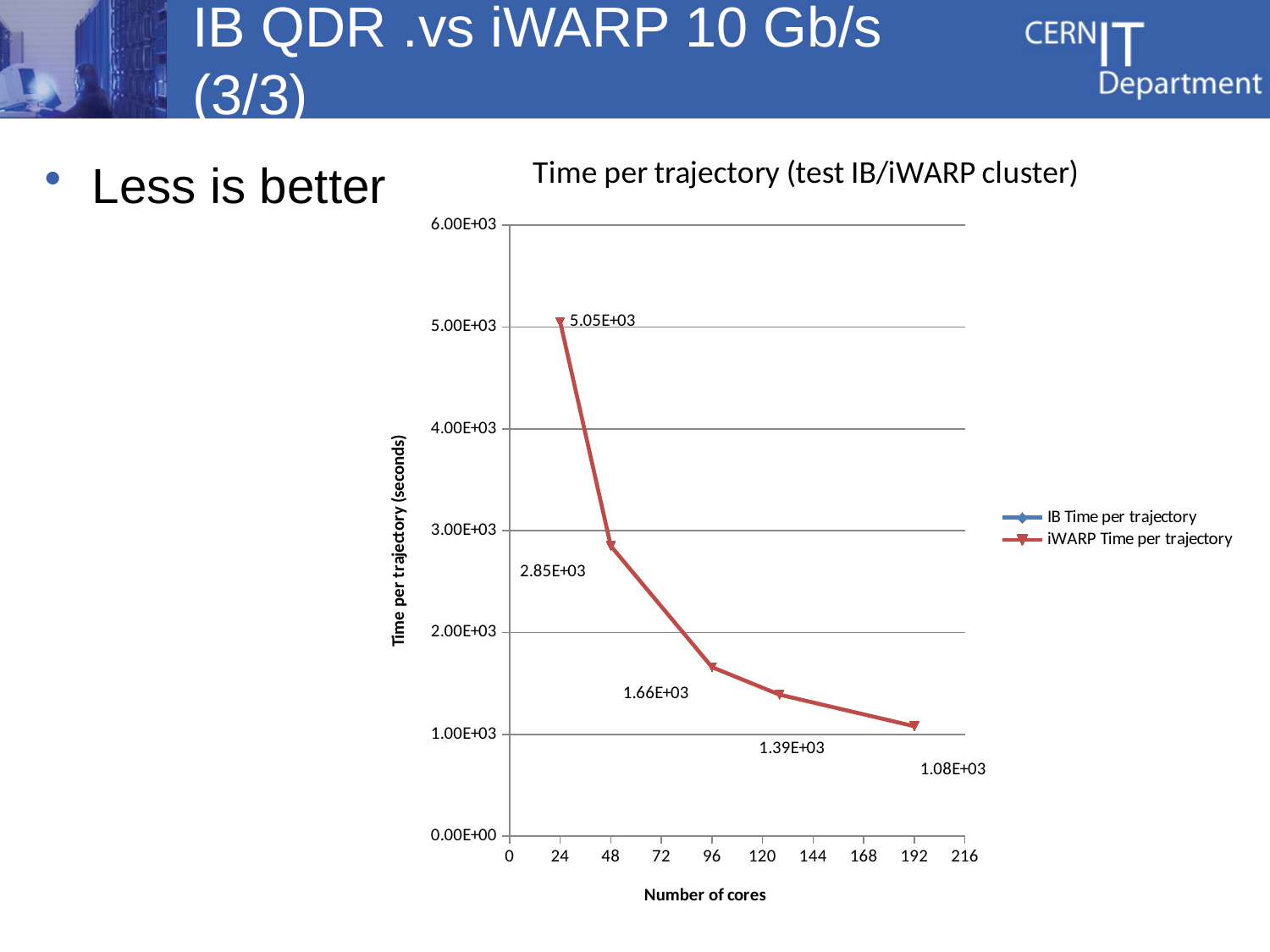
How many series does the chart legend list? 2 What is the lowest labelled value on the chart? 1.08E+03 What is the labelled time per trajectory at 192 cores? 1.08E+03 What is the labelled time per trajectory at 96 cores? 1.66E+03 What kind of chart is shown on the slide? line chart Does the time per trajectory rise or fall as the number of cores increases? fall What is the labelled time per trajectory at 48 cores? 2.85E+03 What is the title of the chart? Time per trajectory (test IB/iWARP cluster) What is the highest labelled value on the chart? 5.05E+03 What is the labelled time per trajectory at 24 cores? 5.05E+03 How many data points are labelled on the plotted line? 5 What is the label of the x axis of the chart? Number of cores